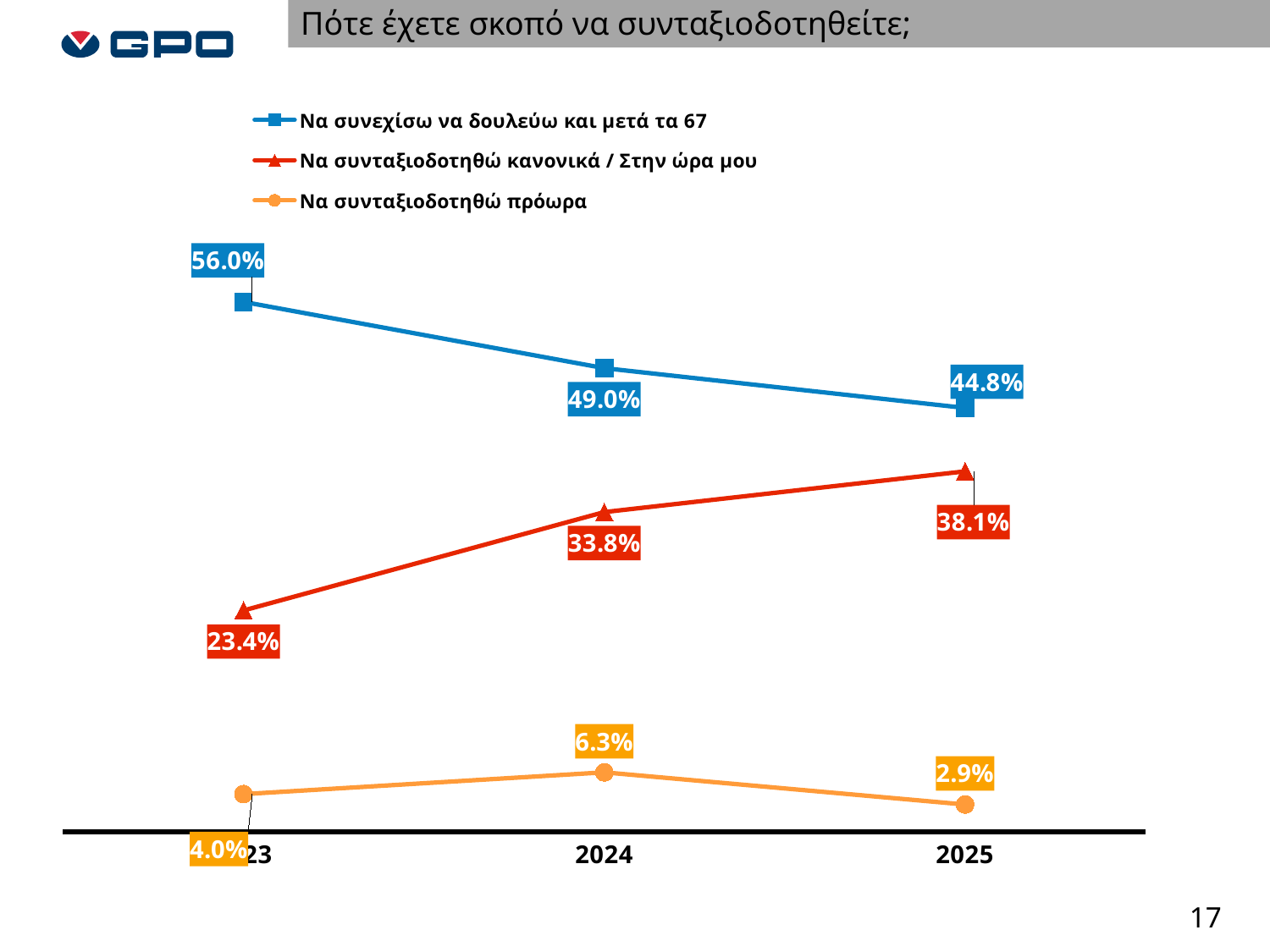
What is the value for 'Να συνταξιοδοτηθώ κανονικά / Στην ώρα μου' in 2025? 38.1% What is the value for 'Να συνεχίσω να δουλεύω και μετά τα 67' in 2025? 44.8% Does the value for 'Να συνεχίσω να δουλεύω και μετά τα 67' rise or fall from 2023 to 2025? fall What is the difference between the 2025 values for 'Να συνεχίσω να δουλεύω και μετά τα 67' and 'Να συνταξιοδοτηθώ κανονικά / Στην ώρα μου'? 6.7% How many years are plotted on the x axis? 3 What kind of chart is shown on the slide? line chart What is the value for 'Να συνταξιοδοτηθώ πρόωρα' in 2024? 6.3% Which series has the larger value in 2024: 'Να συνταξιοδοτηθώ κανονικά / Στην ώρα μου' or 'Να συνταξιοδοτηθώ πρόωρα'? Να συνταξιοδοτηθώ κανονικά / Στην ώρα μου What is the value for 'Να συνεχίσω να δουλεύω και μετά τα 67' in 2024? 49.0% In which year is the value for 'Να συνταξιοδοτηθώ κανονικά / Στην ώρα μου' highest? 2025 How many series does the legend list? 3 In which year is the value for 'Να συνταξιοδοτηθώ πρόωρα' lowest? 2025